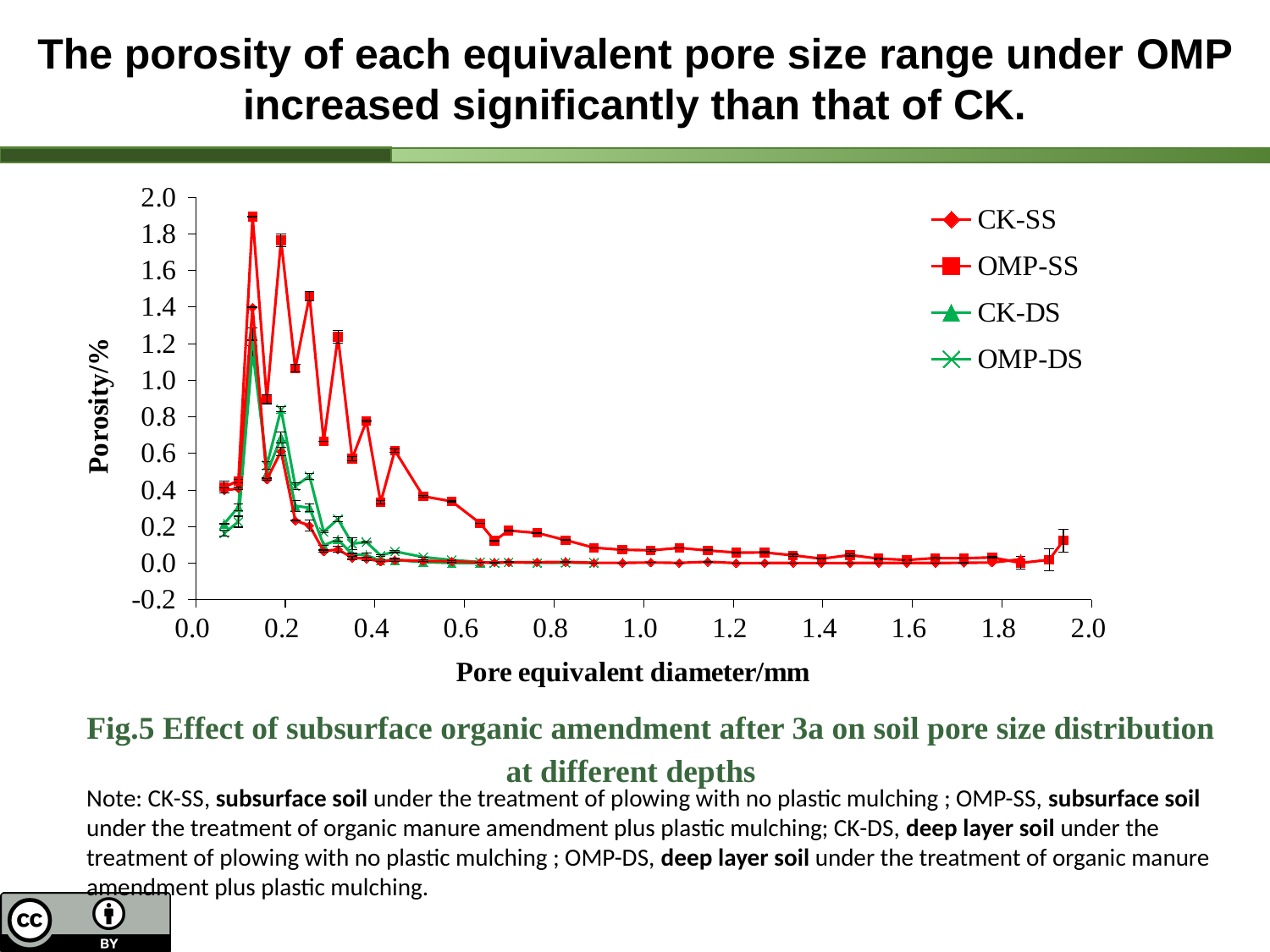
How many series does the legend list? 4 Is the peak value of the CK-DS series greater or less than 1.0? greater Which series has the lowest peak porosity, OMP-SS or CK-DS? CK-DS Is the porosity of OMP-SS at a pore equivalent diameter of 1.0 mm greater or less than 0.2? less Do the porosity values generally rise or fall as the pore equivalent diameter increases beyond 0.2 mm? fall Is the peak value of the OMP-SS series greater or less than 1.6? greater What is the title of the vertical axis? Porosity/% At a pore equivalent diameter of 0.2 mm, which series has the larger porosity, OMP-SS or CK-SS? OMP-SS What kind of chart is shown on the slide? line chart Which series reaches the highest porosity value on the chart? OMP-SS What is the title of the horizontal axis? Pore equivalent diameter/mm